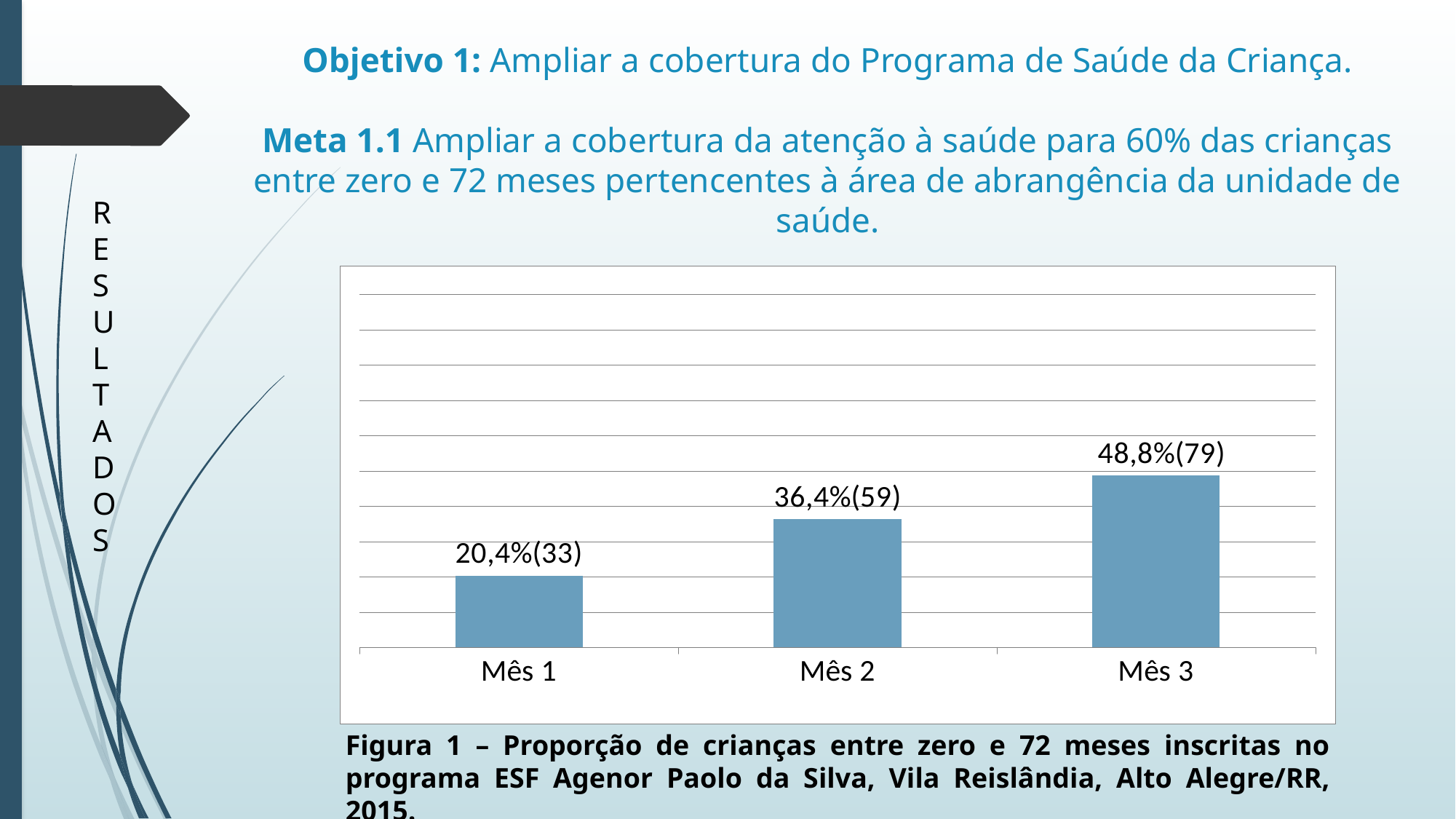
What is the difference in the number of children between Mês 3 and Mês 1? 46 Which is larger, the value for Mês 2 or the value for Mês 3? Mês 3 What percentage is shown for Mês 3? 48,8% What is the data label shown for Mês 3? 48,8%(79) What is the data label shown for Mês 1? 20,4%(33) What kind of chart is shown on the slide? Bar chart Which month has the lowest value? Mês 1 How many children (the number in parentheses) are shown for Mês 2? 59 What is the difference in percentage points between Mês 2 and Mês 1? 16,0 How many months (categories) are shown on the x axis? 3 What is the data label shown for Mês 2? 36,4%(59) Which month has the highest value? Mês 3